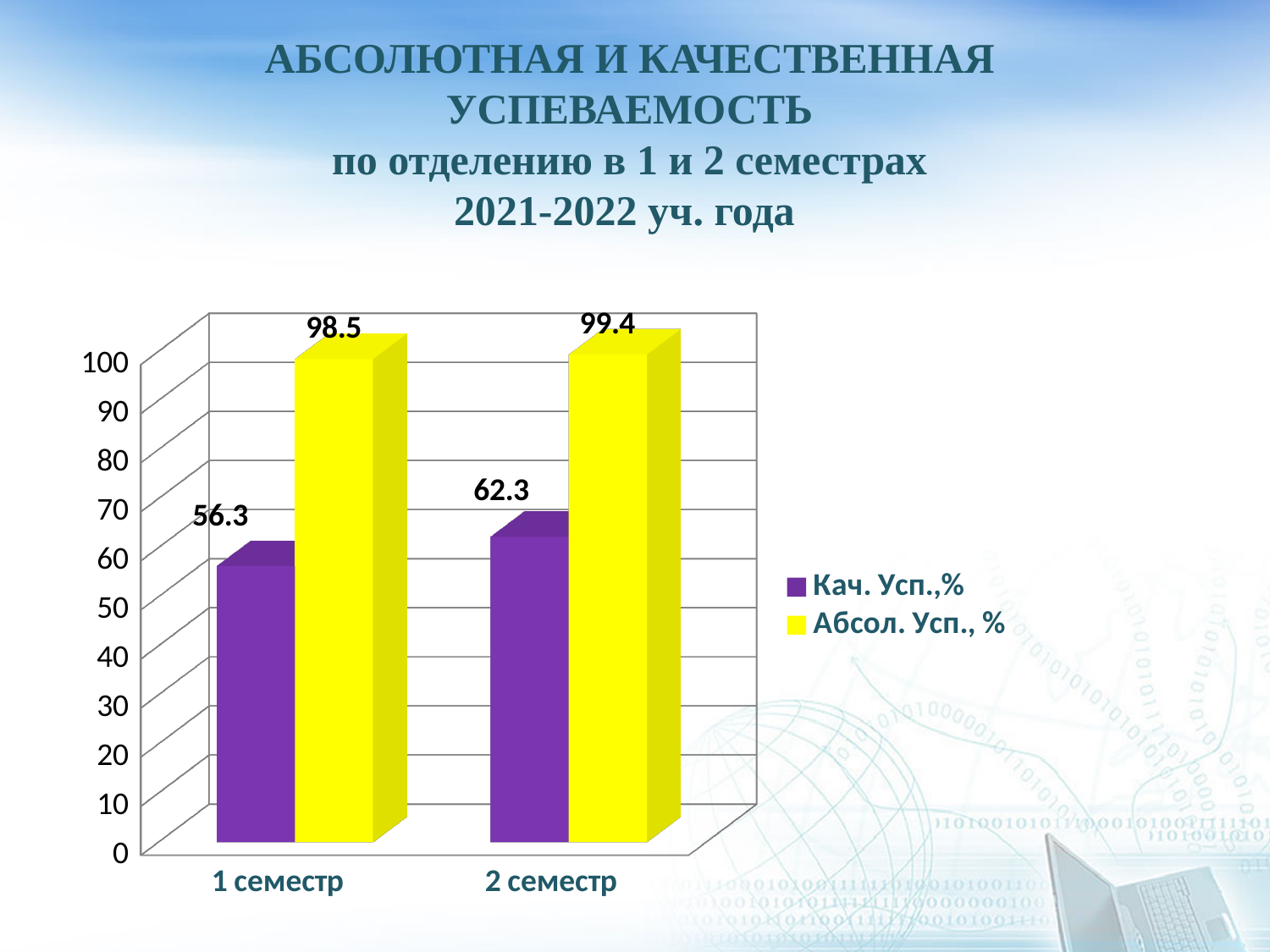
What is the difference between the Кач. Усп.,% values for 2 семестр and 1 семестр? 6 What is the value of Абсол. Усп., % for 1 семестр? 98.5 How many categories are shown on the x axis? 2 What kind of chart is shown on the slide? Bar chart Which semester has the lower Абсол. Усп., % value? 1 семестр Which semester has the higher Кач. Усп.,% value? 2 семестр What is the difference between the Абсол. Усп., % values for 2 семестр and 1 семестр? 0.9 What is the value of Кач. Усп.,% for 1 семестр? 56.3 What is the value of Кач. Усп.,% for 2 семестр? 62.3 Which is larger for 1 семестр: Кач. Усп.,% or Абсол. Усп., %? Абсол. Усп., % How many series does the legend list? 2 What is the value of Абсол. Усп., % for 2 семестр? 99.4